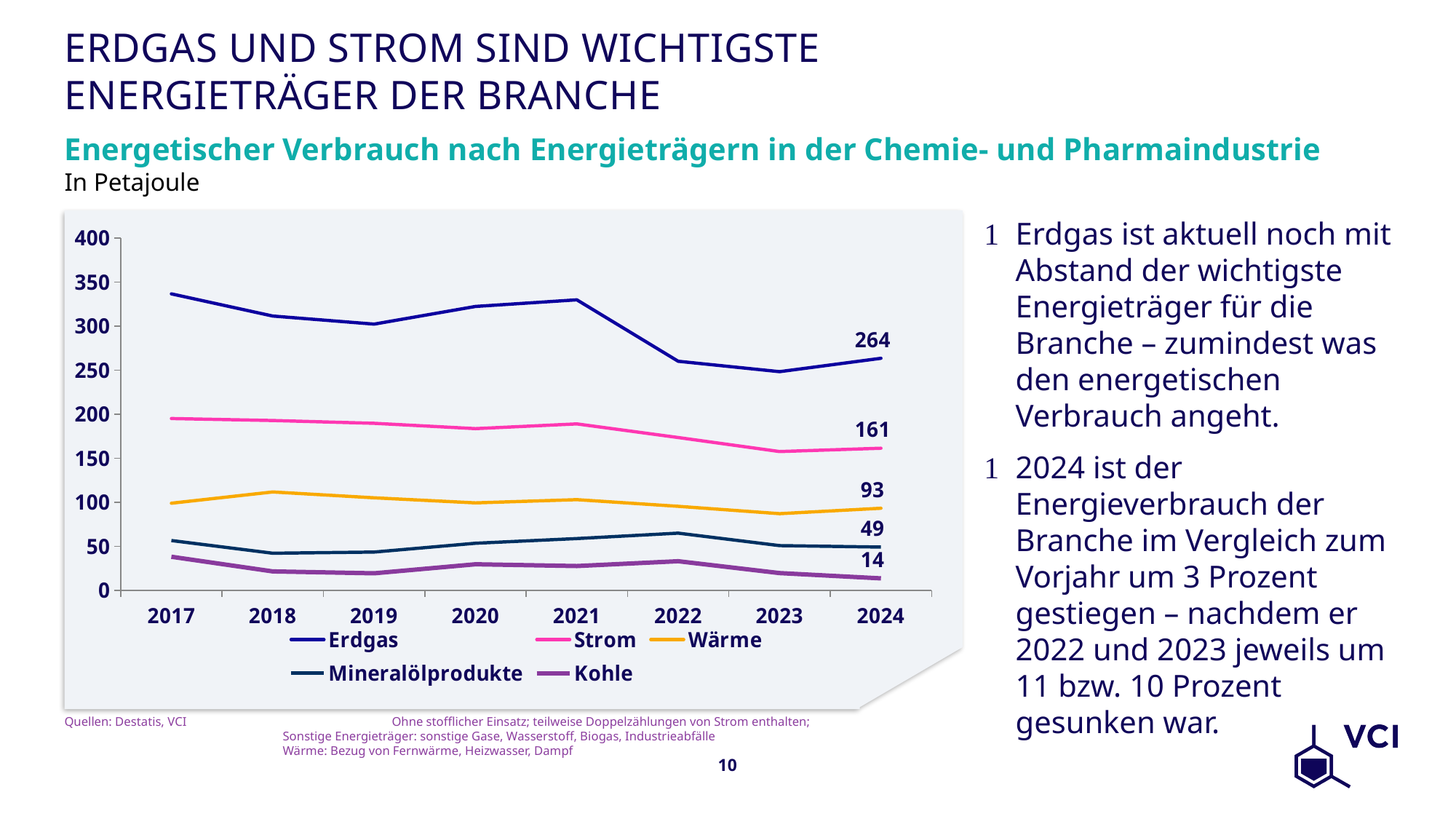
What is the value for Wärme in 2024? 93 What is the value for Strom in 2024? 161 What is the value for Erdgas in 2024? 264 What kind of chart is shown on the slide? line chart Which energy source has the lowest value in 2024? Kohle Does the Erdgas line rise or fall from 2021 to 2023? fall What is the value for Kohle in 2024? 14 Which energy source has the highest value in 2024? Erdgas How many years are shown on the x axis? 8 What is the difference between Erdgas and Strom in 2024? 103 How many series does the legend list? 5 Is the value for Erdgas in 2017 greater or less than 300? greater